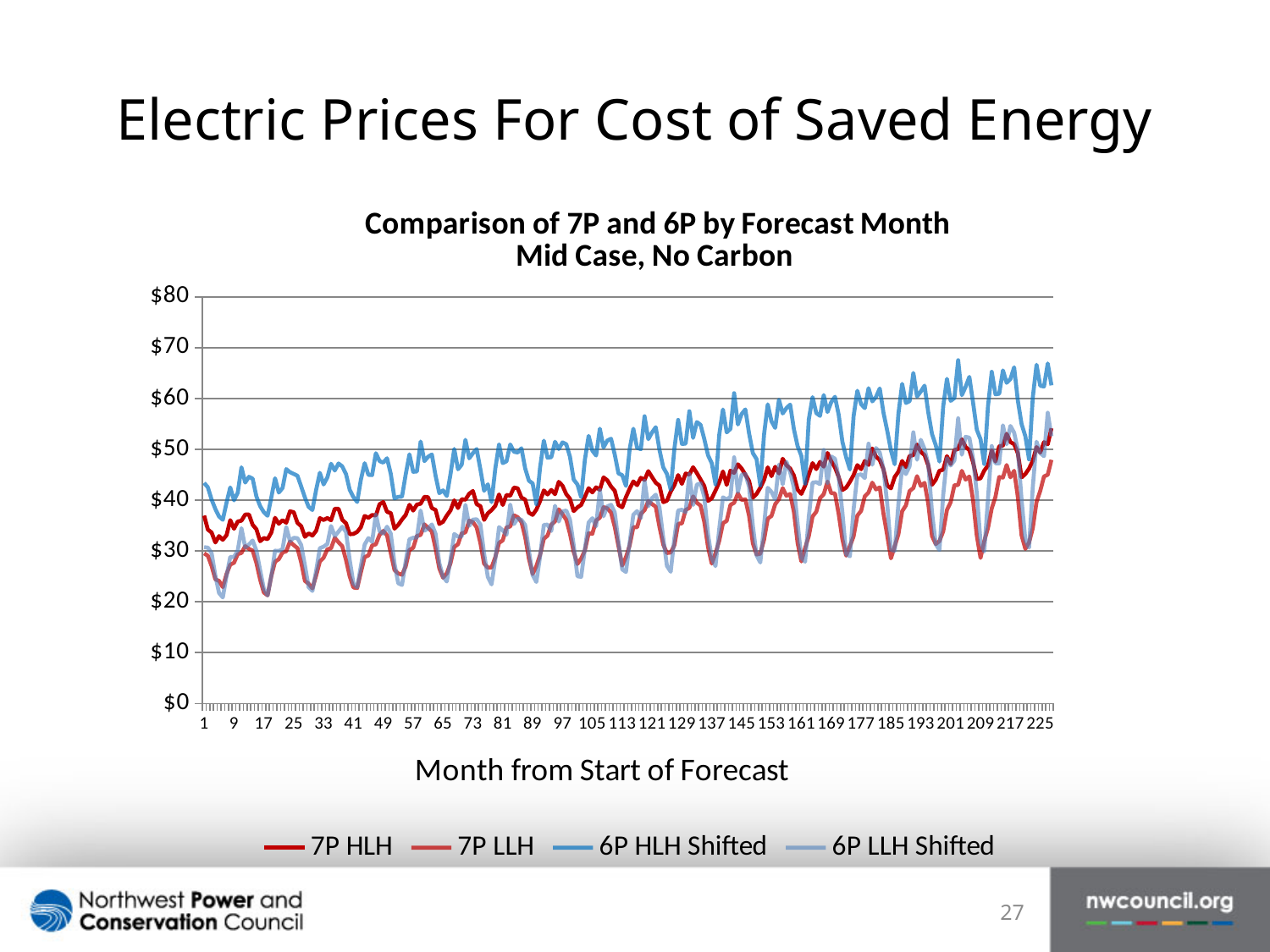
Which series has the highest values across the forecast months? 6P HLH Shifted Does any series reach $70 on the chart? No Are the peak values of 6P HLH Shifted near month 201 greater or less than $60? greater What kind of chart is shown on the slide? Line chart Which series is higher at month 1, 6P HLH Shifted or 7P HLH? 6P HLH Shifted Are the lowest values of 7P LLH in the early months greater or less than $30? less What is the highest value shown on the vertical axis? $80 What is the label of the horizontal axis? Month from Start of Forecast Do the prices generally rise or fall as the month from start of forecast increases? Rise How many series does the legend list? 4